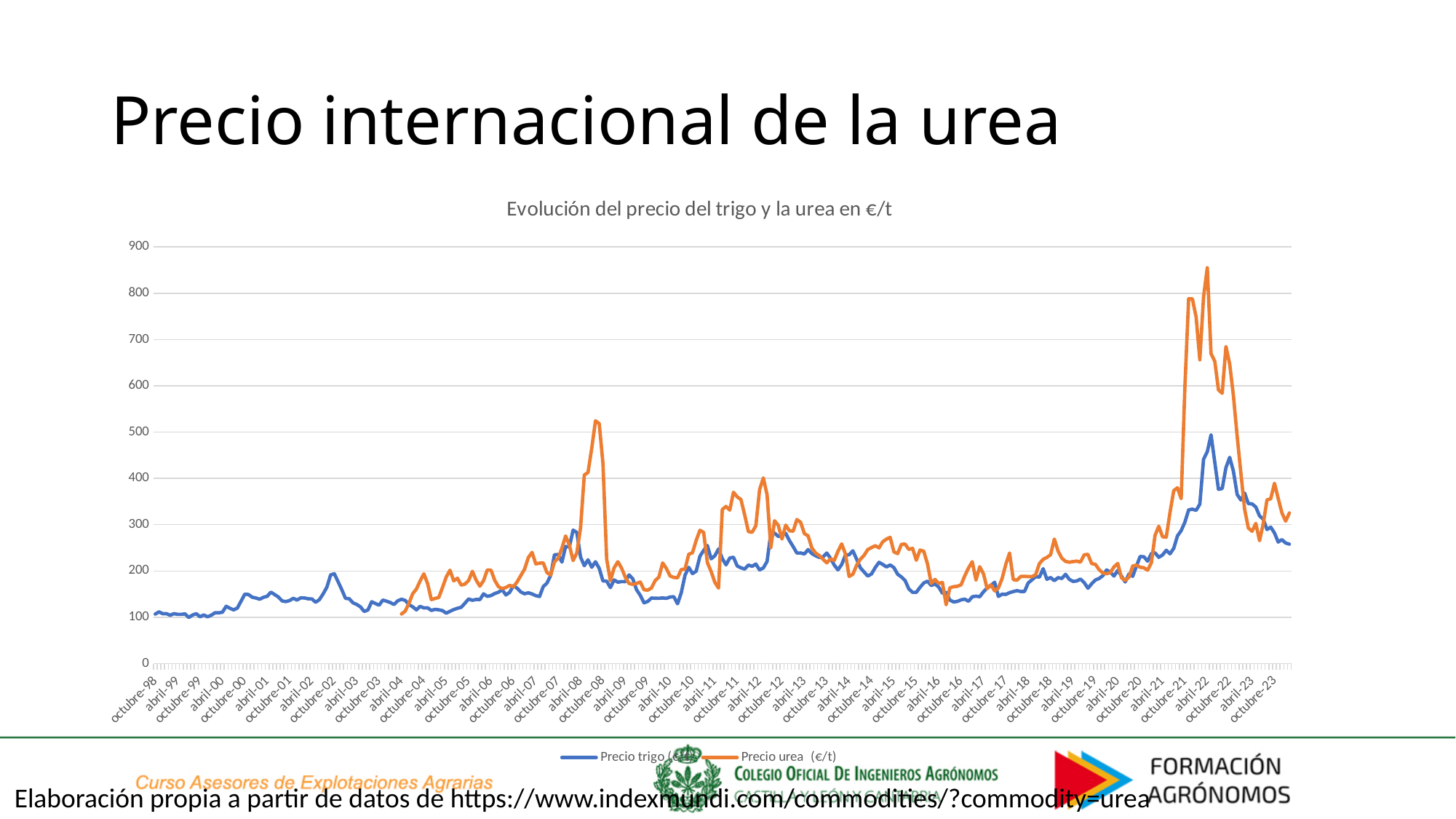
Is the value of Precio urea (€/t) at its peak around octubre-08 greater or less than 400? greater How many series does the chart's legend list? 2 Does the Precio trigo line rise or fall between octubre-98 and octubre-02? rise Which series reaches the highest value on the chart, Precio trigo or Precio urea (€/t)? Precio urea (€/t) Is the value of Precio trigo at octubre-98 greater or less than 200? less Does the Precio urea (€/t) line rise or fall between abril-22 and octubre-23? fall Is the peak value of Precio urea (€/t) around abril-22 greater or less than 800? greater What is the title of the chart? Evolución del precio del trigo y la urea en €/t What kind of chart is shown on the slide? line chart Around abril-22, which series has the higher value, Precio trigo or Precio urea (€/t)? Precio urea (€/t) What colour is the line for Precio urea (€/t)? orange